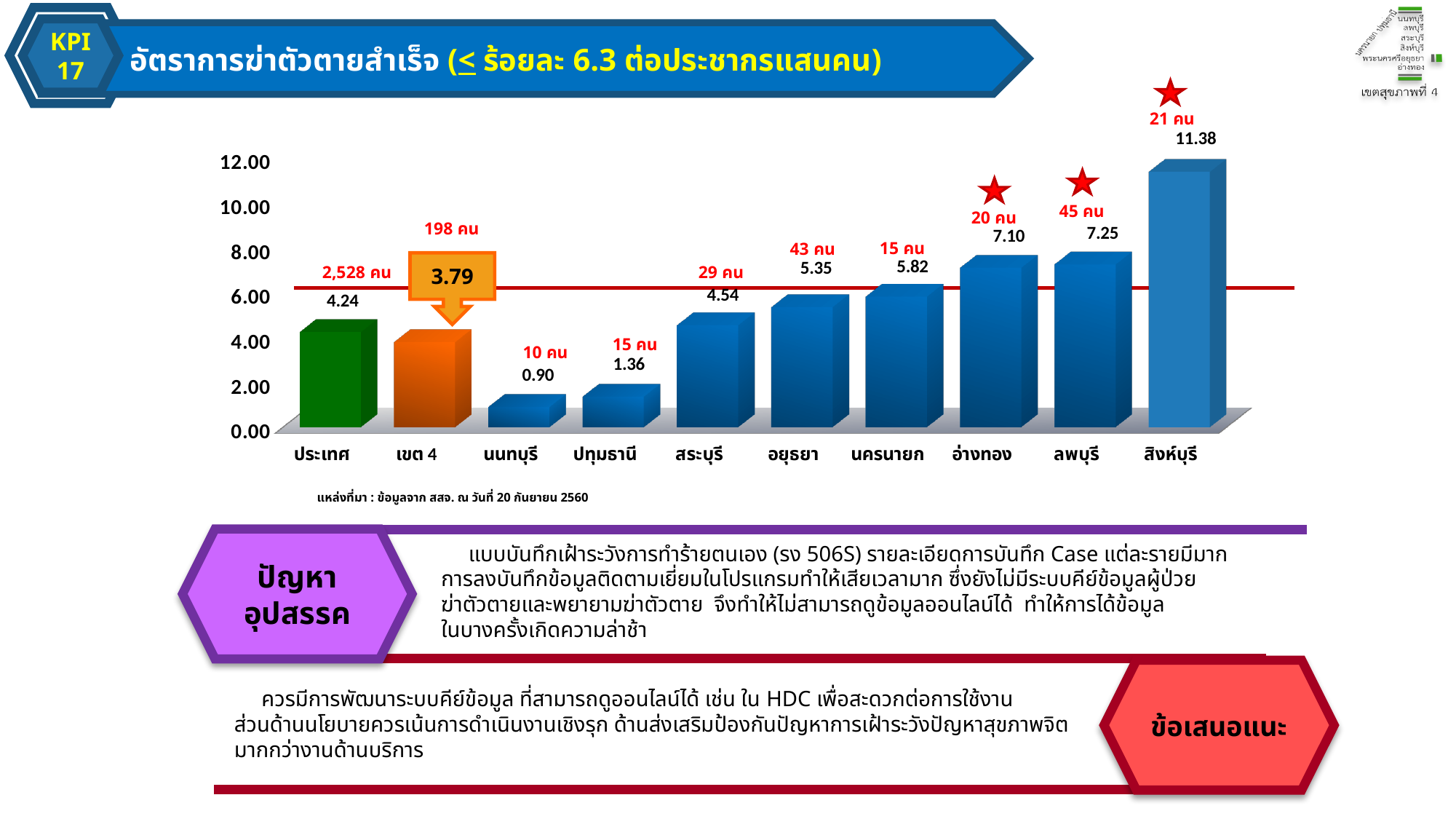
What is the value shown for สิงห์บุรี? 11.38 What is the value shown for เขต 4? 3.79 What is the value shown for นนทบุรี? 0.90 What is the difference between the values for ลพบุรี and อ่างทอง? 0.15 Which category has the lowest value? นนทบุรี What is the red count label shown above the ประเทศ bar? 2,528 คน Which category has the highest value? สิงห์บุรี What kind of chart is shown on the slide? bar chart What is the highest tick value shown on the y axis? 12.00 Which is larger, the value for ประเทศ or the value for สระบุรี? สระบุรี How many categories are shown on the x axis? 10 Is the value for นครนายก greater or less than 6.00? less